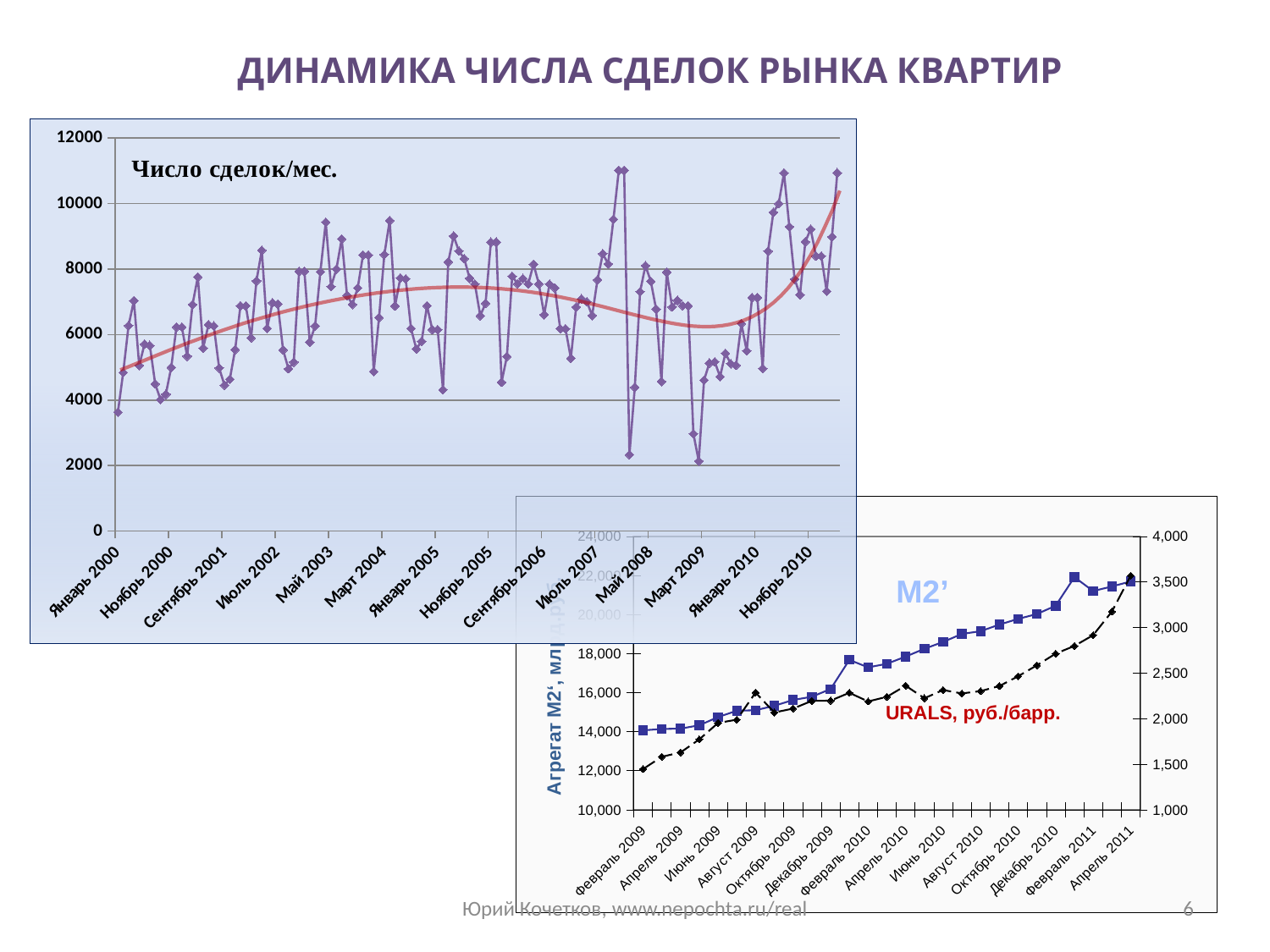
In the top-left chart 'Число сделок/мес.', does the red smoothed trend line rise or fall between Январь 2000 and Май 2003? rises In the bottom-right chart, is the M2' value for Апрель 2011 greater or less than 20,000? greater In the bottom-right chart, does the M2' series rise or fall from Февраль 2009 to Апрель 2011? rises In the top-left chart 'Число сделок/мес.', is the value for Январь 2000 greater or less than 4000? less In the top-left chart 'Число сделок/мес.', is the lowest plotted value greater or less than 4000? less What kind of chart is the top-left chart titled 'Число сделок/мес.'? line chart What kind of chart is the bottom-right chart showing M2' and URALS? line chart In the bottom-right chart, what colour is the M2' line? blue What is the label printed inside the plot area of the top-left chart? Число сделок/мес. How many series are plotted in the bottom-right chart showing M2' and URALS? 2